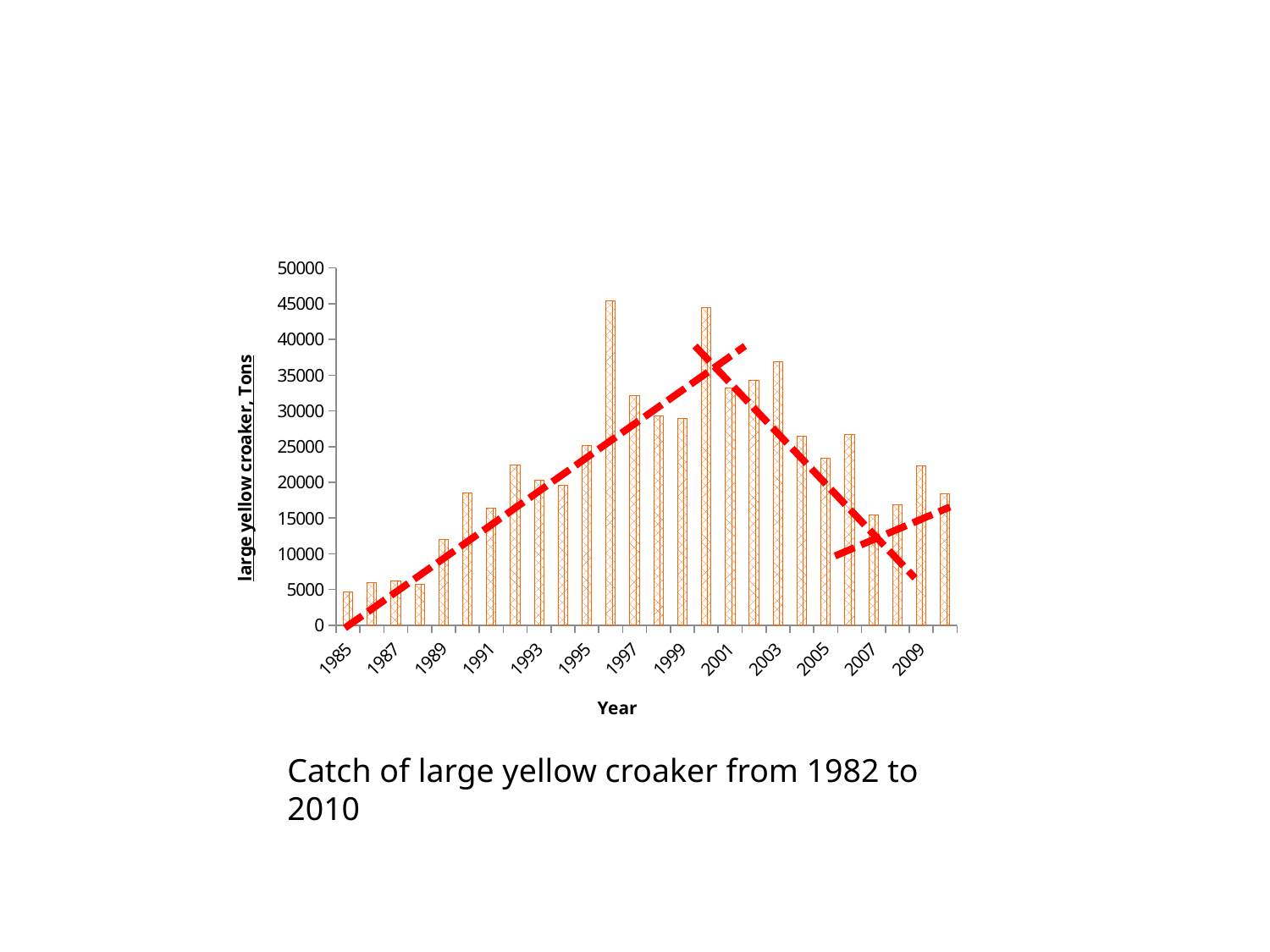
Is the value for 1995 greater or less than 20000? greater What is the title of the y axis? large yellow croaker, Tons Which year has the larger value, 2003 or 2004? 2003 Is the value for 1986 greater or less than 10000? less Is the value for 2007 greater or less than 20000? less What is the title of the x axis? Year Which year has the larger value, 1996 or 1997? 1996 What kind of chart is shown on the slide? bar chart Which year has the larger value, 2007 or 2009? 2009 Do the values generally rise or fall from 1985 to 1996? rise